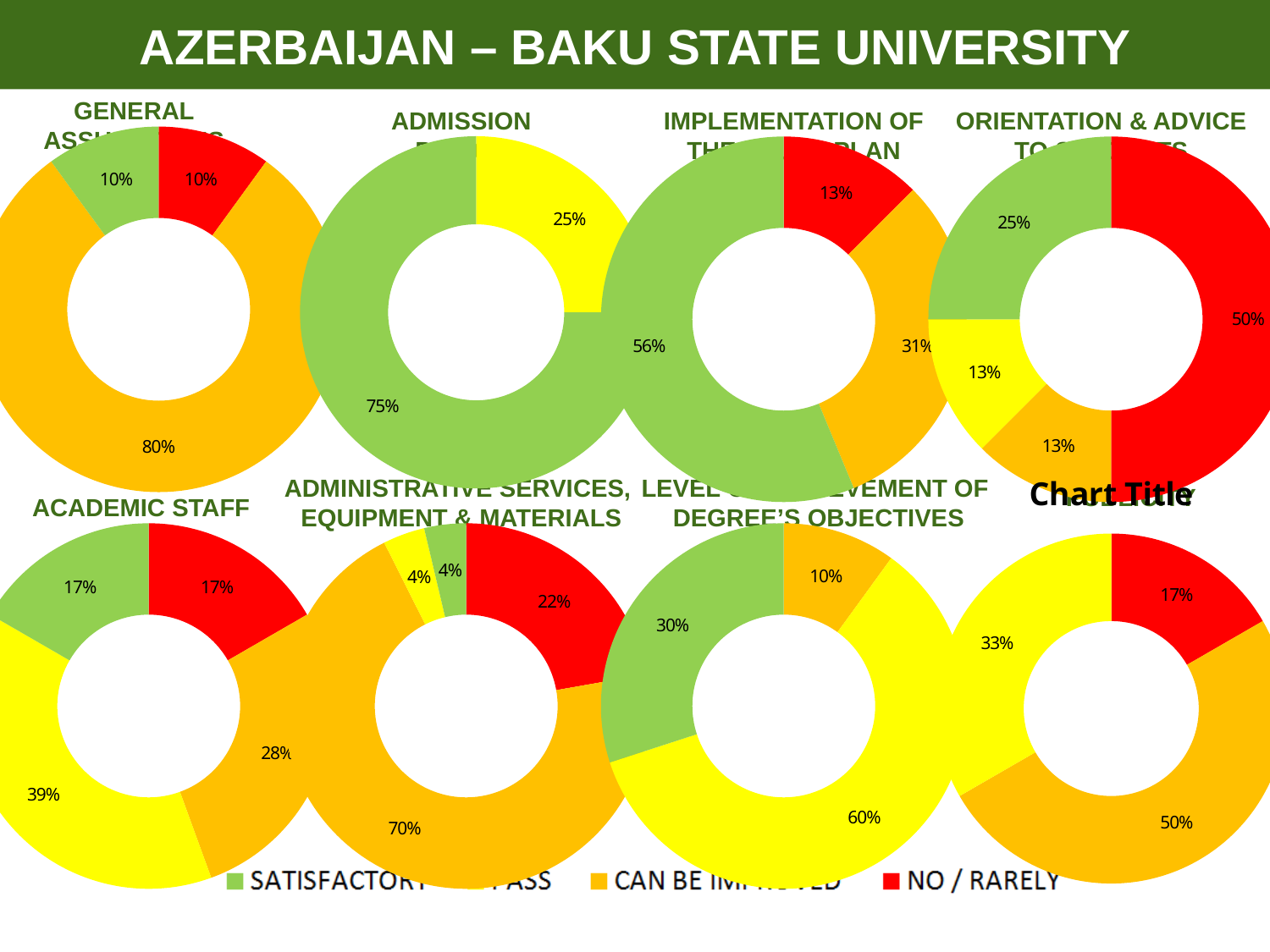
In the ADMINISTRATIVE SERVICES, EQUIPMENT & MATERIALS chart, what percentage is shown for NO / RARELY (red)? 22% In the chart titled 'Chart Title' (bottom right), what percentage is shown for CAN BE IMPROVED (orange)? 50% In the chart titled 'Chart Title' (bottom right), what is the difference between the PASS share and the NO / RARELY share? 16% In the LEVEL OF ACHIEVEMENT OF DEGREE'S OBJECTIVES chart, which category has the smallest share? CAN BE IMPROVED In the LEVEL OF ACHIEVEMENT OF DEGREE'S OBJECTIVES chart, what percentage is shown for SATISFACTORY (green)? 30% In the ORIENTATION & ADVICE chart (top right), what percentage is shown for NO / RARELY (red)? 50% In the ADMINISTRATIVE SERVICES, EQUIPMENT & MATERIALS chart, which category has the largest share? CAN BE IMPROVED How many categories does the legend at the bottom of the slide list? 4 In the ACADEMIC STAFF chart, what percentage is shown for CAN BE IMPROVED (orange)? 28% How many donut charts are shown on the slide? 8 In the top-left chart (GENERAL ...), what percentage is shown for CAN BE IMPROVED (orange)? 80% In the ACADEMIC STAFF chart, what percentage is labelled for the PASS (yellow) slice? 39%